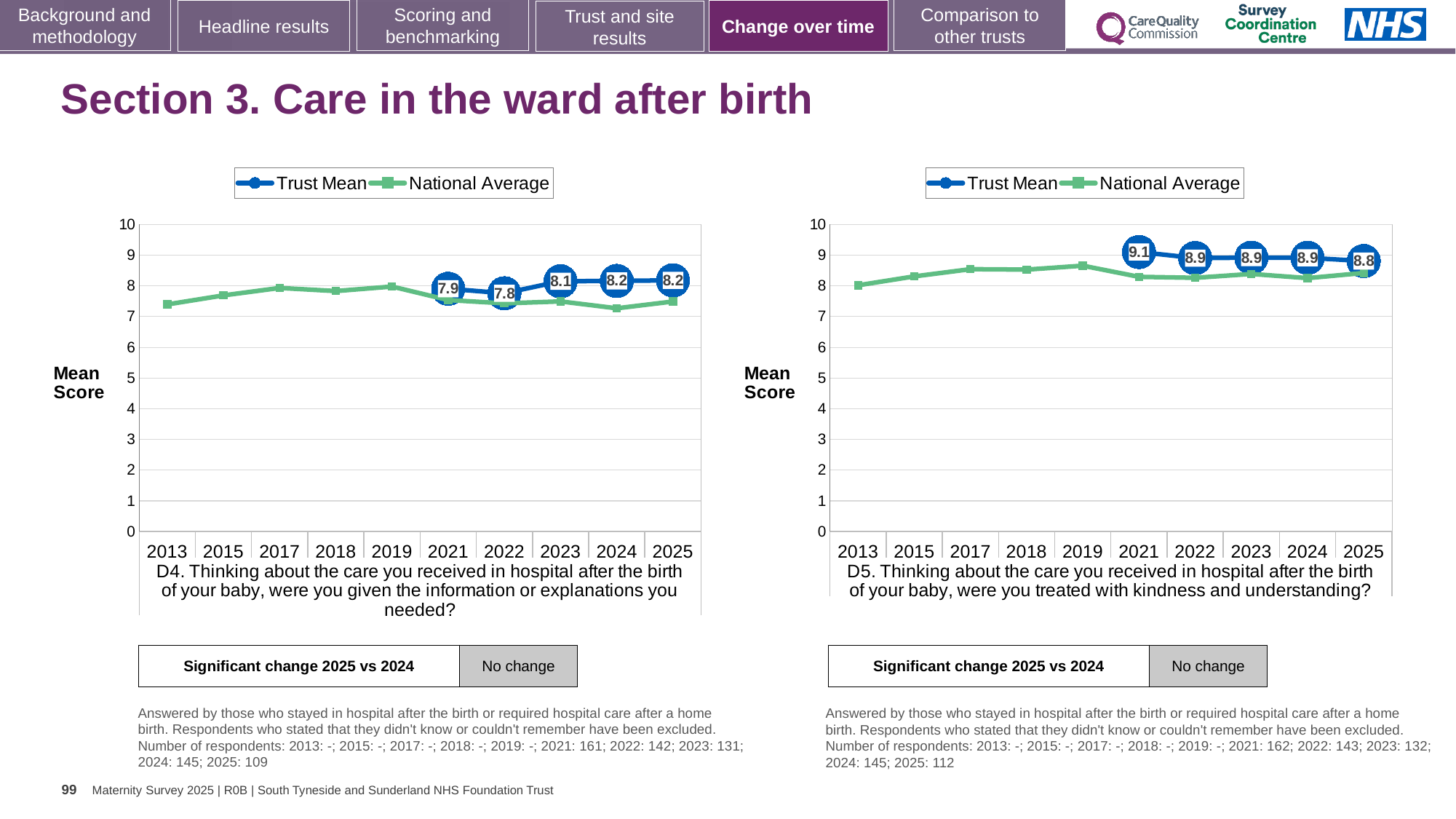
In the D4 chart on the left, what is the Trust Mean for 2025? 8.2 In the D5 chart on the right, which year has the highest Trust Mean? 2021 What type of chart is the D4 chart on the left? Line chart How many years are shown on the x axis of the D4 chart on the left? 10 In the D5 chart on the right, what is the Trust Mean for 2021? 9.1 In the D4 chart on the left, what is the Trust Mean for 2022? 7.8 In the D5 chart on the right, what is the difference between the Trust Mean in 2021 and in 2025? 0.3 How many series does the legend of the D5 chart on the right list? 2 In the D4 chart on the left, is the Trust Mean higher in 2023 or in 2022? 2023 In the D4 chart on the left, which year has the lowest labelled Trust Mean? 2022 In the D5 chart on the right, is the National Average for 2013 greater or less than 9? less In the D4 chart on the left, what is the difference between the Trust Mean in 2025 and in 2021? 0.3